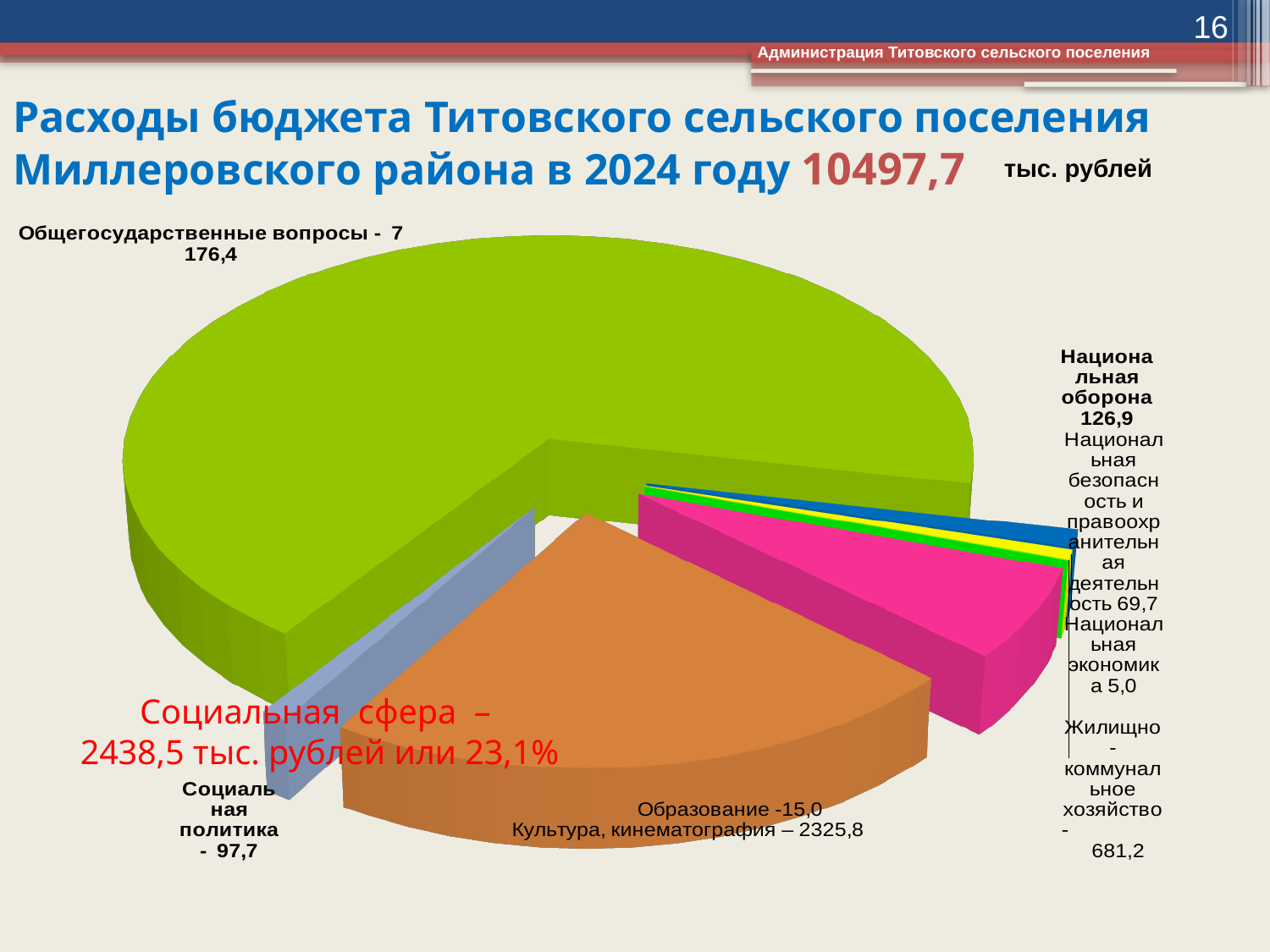
What is the value for Культура, кинематография? 2325,8 Which category has the largest slice of the pie? Общегосударственные вопросы What is the value for Общегосударственные вопросы? 7 176,4 What is the value for Национальная оборона? 126,9 How many categories are shown in the pie chart? 7 What is the difference between Культура, кинематография and Жилищно-коммунальное хозяйство? 1644,6 What is the value for Социальная политика? 97,7 What kind of chart is shown on the slide? Pie chart Which is larger: Национальная оборона or Национальная безопасность и правоохранительная деятельность? Национальная оборона What is the value for Жилищно-коммунальное хозяйство? 681,2 Which category has the smallest value? Национальная экономика What total budget expenditure (in тыс. рублей) is stated in the slide title? 10497,7